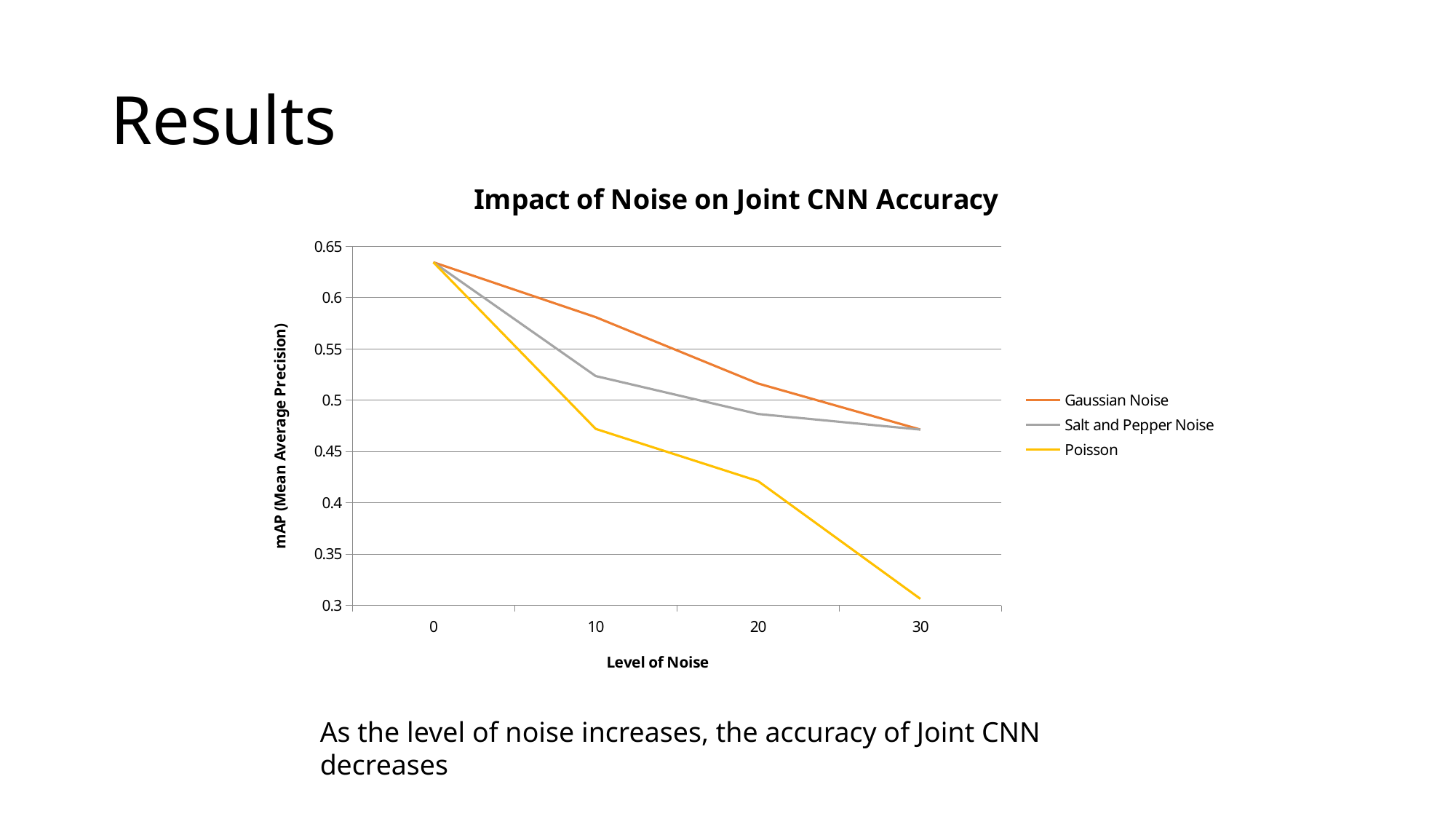
Do the mAP values rise or fall as the level of noise increases? fall How many series does the legend list? 3 What kind of chart is shown on the slide? line chart What is the title of the chart? Impact of Noise on Joint CNN Accuracy What is the label of the y axis? mAP (Mean Average Precision) Which series has the lowest mAP at a noise level of 30? Poisson How many levels of noise are plotted along the x axis? 4 Is the mAP for Poisson at a noise level of 10 greater or less than 0.5? less Which series has the highest mAP at a noise level of 10? Gaussian Noise Is the mAP for Poisson at a noise level of 30 greater or less than 0.35? less Is the mAP for Gaussian Noise at a noise level of 10 greater or less than 0.55? greater At a noise level of 20, which is larger: the mAP for Gaussian Noise or for Poisson? Gaussian Noise